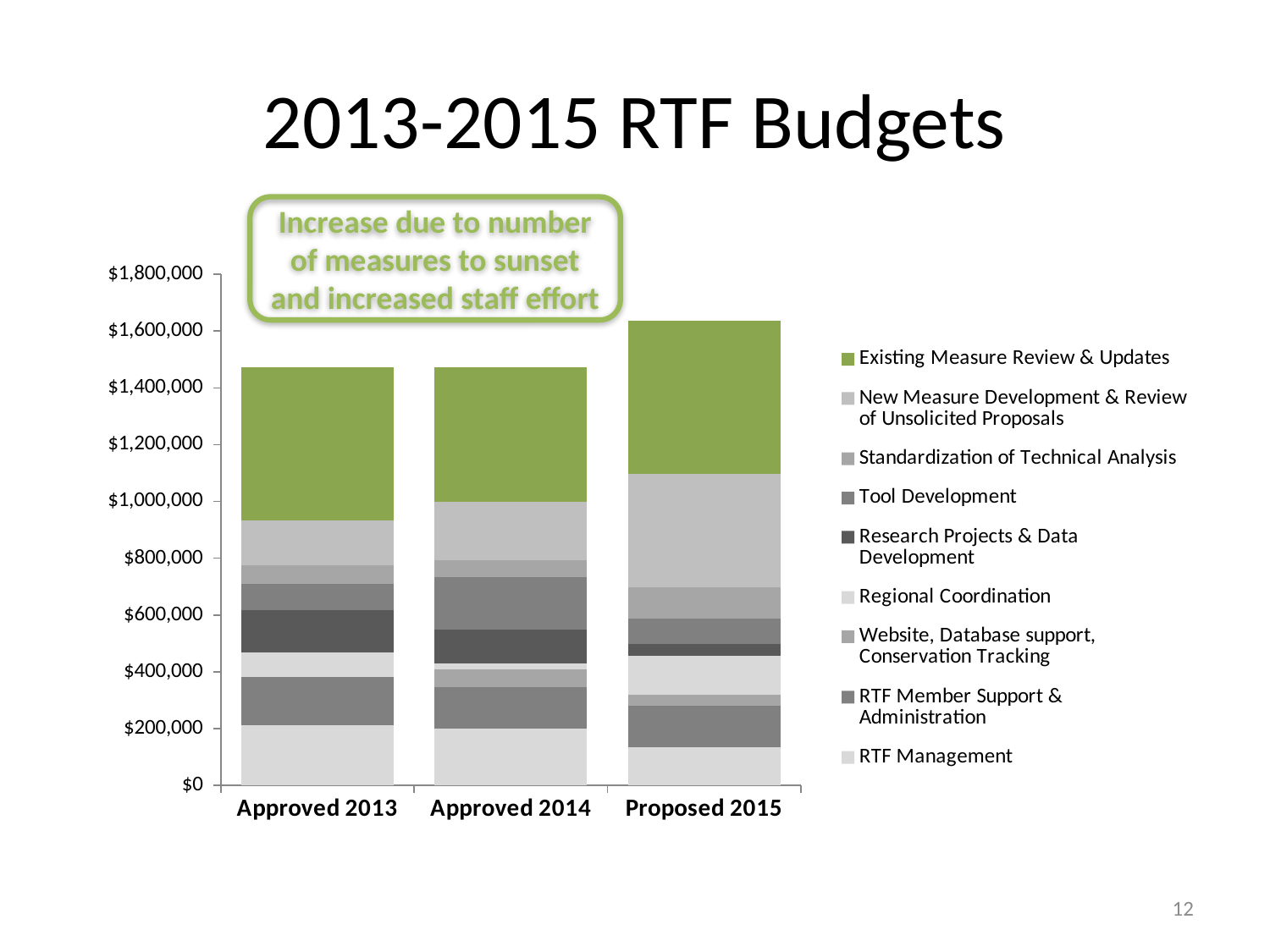
How many series does the legend list? 9 Is the total for Proposed 2015 greater or less than $1,400,000? greater From Approved 2014 to Proposed 2015, does the total budget rise or fall? Rise What is the title of the slide? 2013-2015 RTF Budgets Is the total for Approved 2014 greater or less than $1,400,000? greater Which legend entry is shown in green at the top of each bar? Existing Measure Review & Updates Which budget year has the highest total bar? Proposed 2015 What kind of chart is shown on the slide? Stacked bar chart Is the total for Approved 2013 greater or less than $1,600,000? less How many budget years (categories) are shown on the x axis? 3 Which is larger, the total for Approved 2013 or the total for Proposed 2015? Proposed 2015